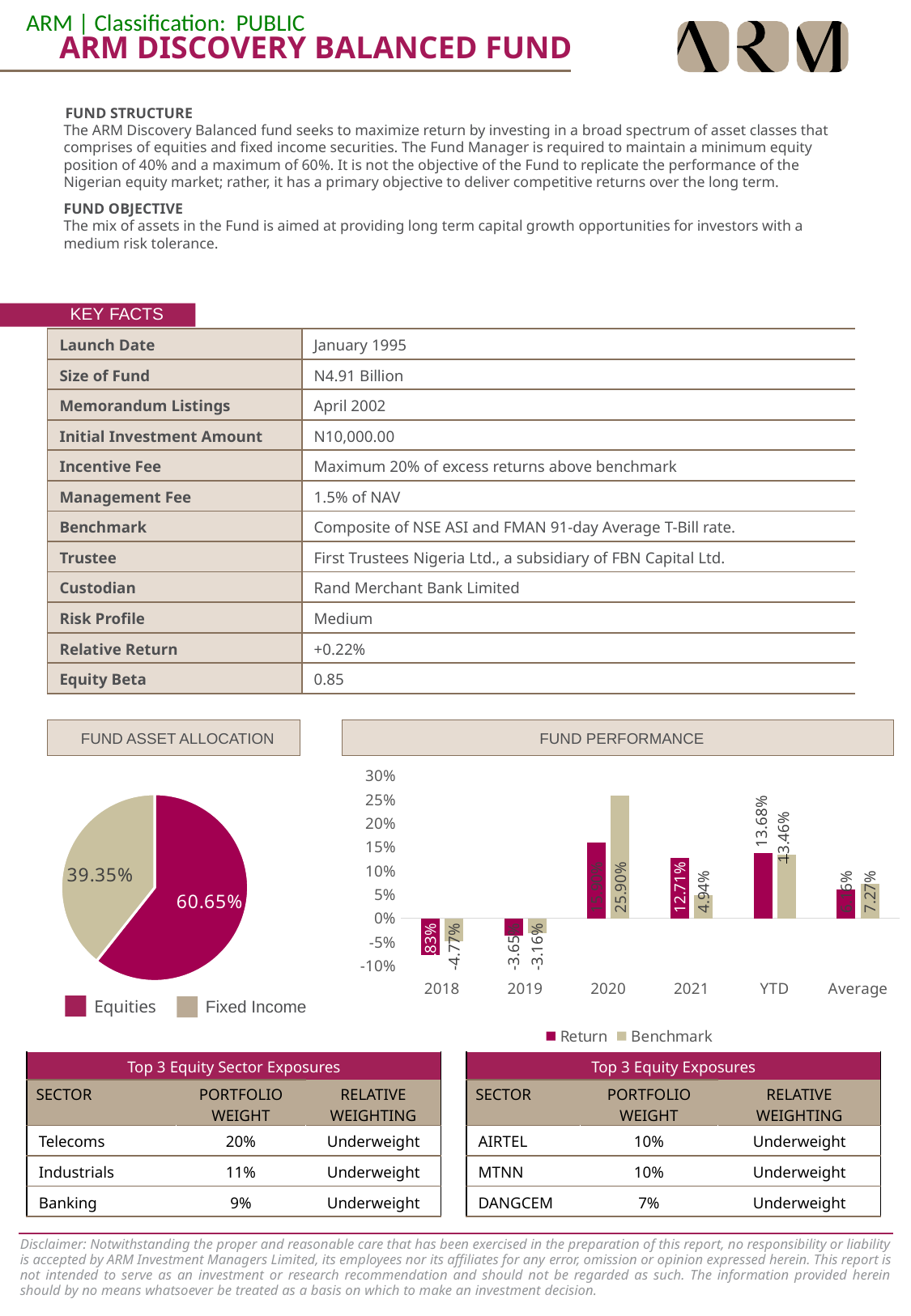
What kind of chart is the FUND ASSET ALLOCATION chart? Pie chart In the FUND PERFORMANCE chart, what is the Benchmark value for 2021? 4.94% In the FUND PERFORMANCE chart, which category has the highest Benchmark value? 2020 In the FUND PERFORMANCE chart, what is the Return value for 2021? 12.71% In the FUND PERFORMANCE chart, what is the Return value for YTD? 13.68% How many categories are shown on the x axis of the FUND PERFORMANCE chart? 6 In the FUND ASSET ALLOCATION chart, what share of the fund is in Fixed Income? 39.35% In the FUND PERFORMANCE chart, what is the difference between the Return and the Benchmark for 2021? 7.77% How many series does the legend of the FUND PERFORMANCE chart list? 2 In the FUND ASSET ALLOCATION chart, what share of the fund is in Equities? 60.65% What kind of chart is the FUND PERFORMANCE chart? Bar chart In the FUND ASSET ALLOCATION chart, which slice is larger, Equities or Fixed Income? Equities